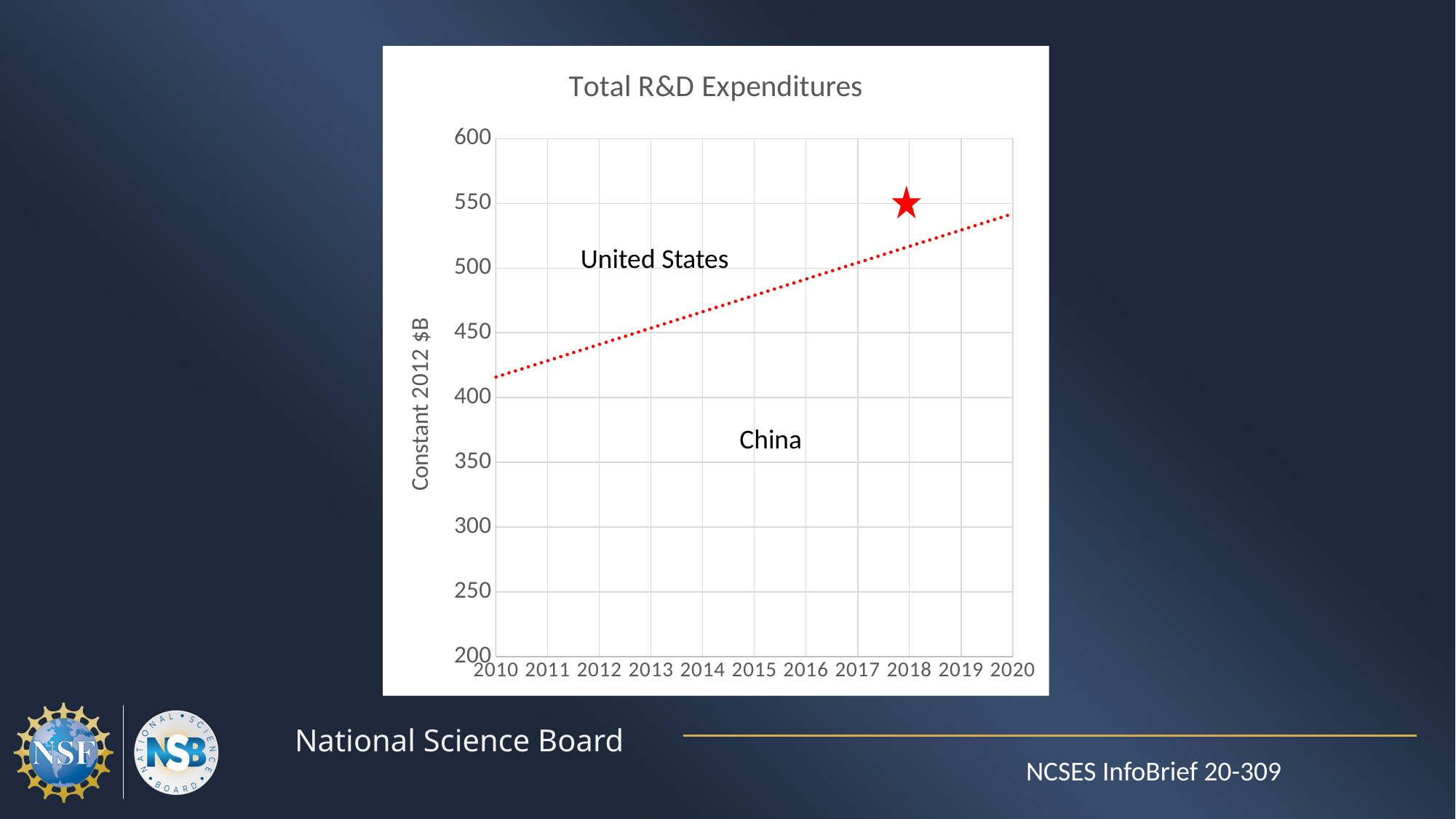
What kind of chart is shown on the slide? line chart Is the value of the dotted line in 2010 greater or less than 450? less Is the value of the dotted line in 2020 greater or less than 550? less What is the title of the chart? Total R&D Expenditures What is the label on the vertical axis of the chart? Constant 2012 $B Which year on the horizontal axis is the red star positioned above? 2018 Is the red star marker placed at a value greater or less than 500? greater How many years are labelled on the horizontal axis? 11 Does the dotted line rise or fall from 2010 to 2020? rise